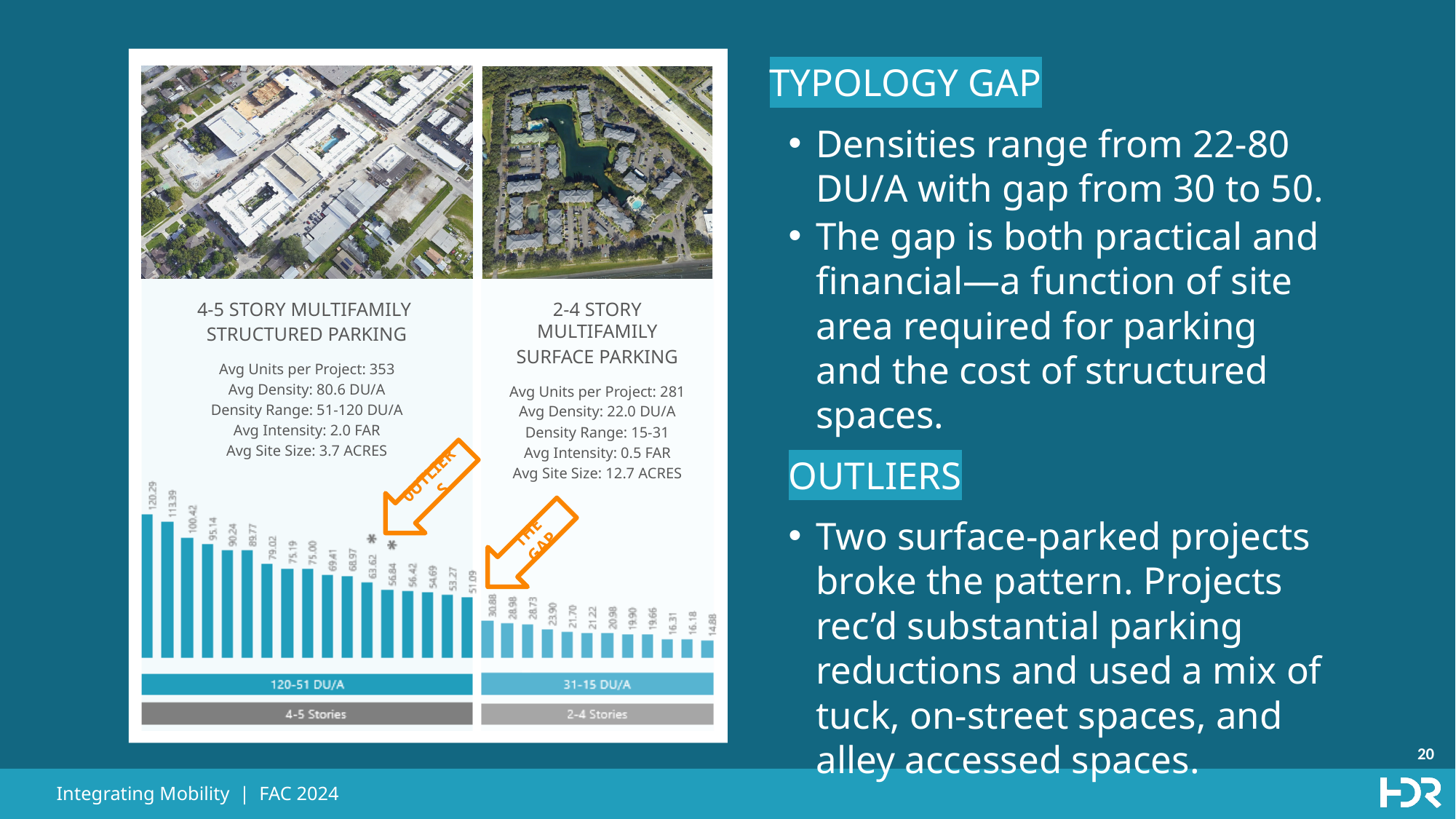
In the 4-5 Story Multifamily Structured Parking chart, what is the highest value shown? 120.29 In the 4-5 Story Multifamily Structured Parking chart, do the values rise or fall from left to right? Fall What is the difference between the highest and lowest values in the 4-5 Story Multifamily Structured Parking chart? 69.20 How many bars are in the 4-5 Story Multifamily Structured Parking chart? 17 Which is larger: the lowest value in the 4-5 Story Structured Parking chart or the highest value in the 2-4 Story Surface Parking chart? The lowest value in the 4-5 Story Structured Parking chart (51.09) In the 4-5 Story Multifamily Structured Parking chart, what is the lowest value shown? 51.09 What is the difference between the highest and lowest values in the 2-4 Story Multifamily Surface Parking chart? 16.00 In the 2-4 Story Multifamily Surface Parking chart, what is the highest value shown? 30.88 What type of chart is shown under the 4-5 Story Multifamily Structured Parking panel? Bar chart What density range label appears beneath the 2-4 Story Multifamily Surface Parking chart? 31-15 DU/A How many bars are in the 2-4 Story Multifamily Surface Parking chart? 12 In the 2-4 Story Multifamily Surface Parking chart, what is the lowest value shown? 14.88